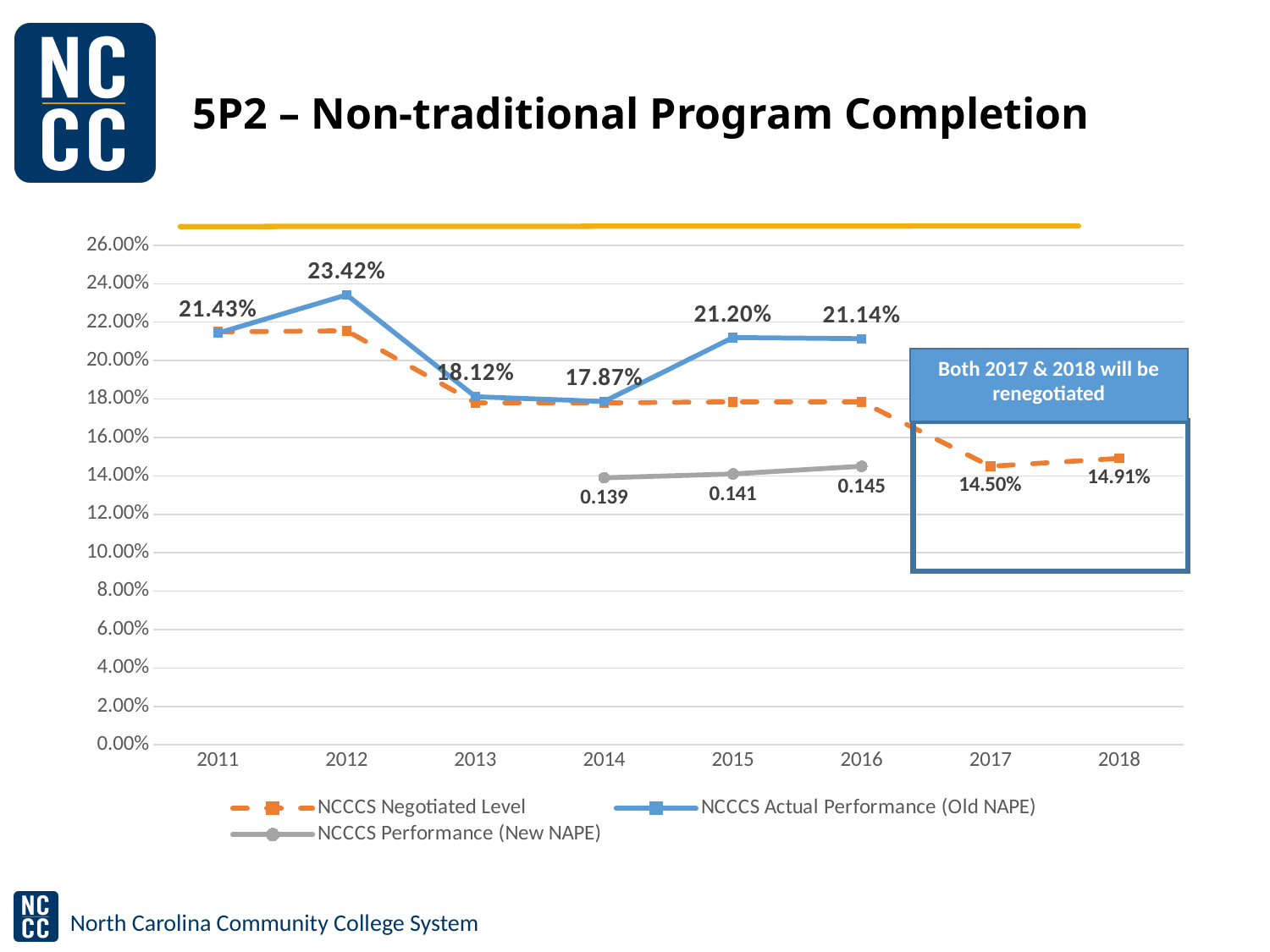
How many series does the chart's legend list? 3 Which year has the higher NCCCS Actual Performance (Old NAPE) value, 2015 or 2016? 2015 What is the NCCCS Negotiated Level for 2018? 14.91% Is the NCCCS Negotiated Level for 2011 greater or less than 20.00%? greater What was the NCCCS Actual Performance (Old NAPE) value in 2012? 23.42% In which year was the NCCCS Actual Performance (Old NAPE) lowest? 2014 Does the NCCCS Performance (New NAPE) series rise or fall from 2014 to 2016? rise By how many percentage points did the NCCCS Actual Performance (Old NAPE) increase from 2011 to 2012? 1.99 percentage points What was the NCCCS Actual Performance (Old NAPE) value in 2015? 21.20% How many years are shown on the x axis of the chart? 8 What is the NCCCS Performance (New NAPE) value for 2014? 0.139 In which year was the NCCCS Actual Performance (Old NAPE) highest? 2012